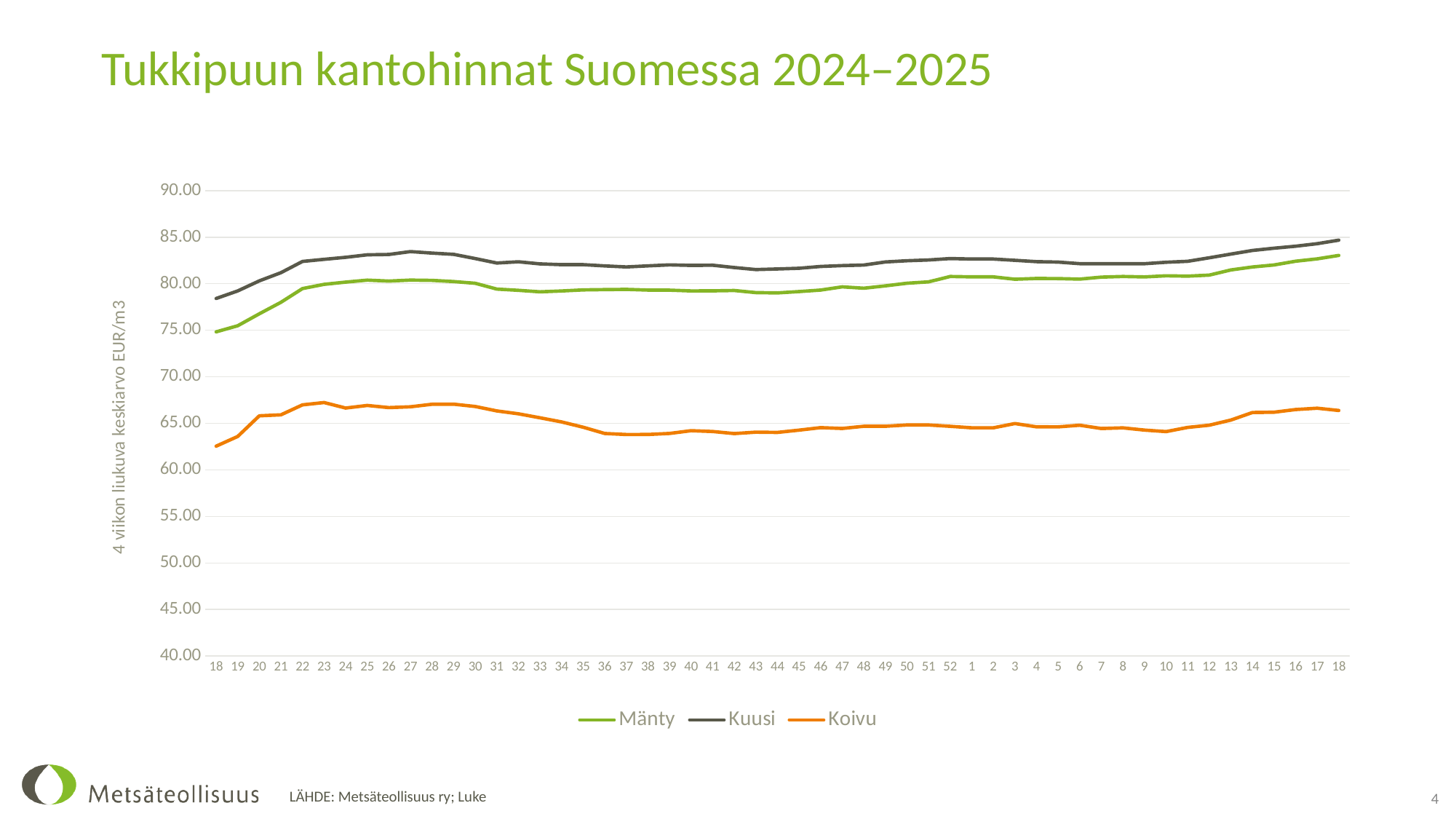
Is the value for Kuusi at the last week 18 greater or less than 80.00? greater Is the value for Kuusi at the first week 18 greater or less than 80.00? less What are the three series named in the legend? Mänty, Kuusi, Koivu What kind of chart is shown on the slide? line chart Which series has the highest values across the whole period? Kuusi What is the title of the chart on the slide? Tukkipuun kantohinnat Suomessa 2024–2025 Is the value for Koivu at week 36 greater or less than 65.00? less Does the Koivu line rise or fall between week 18 and week 23? rise How many series does the legend list? 3 Which series has the lowest values across the whole period? Koivu At week 30, which is larger, the value for Kuusi or the value for Mänty? Kuusi